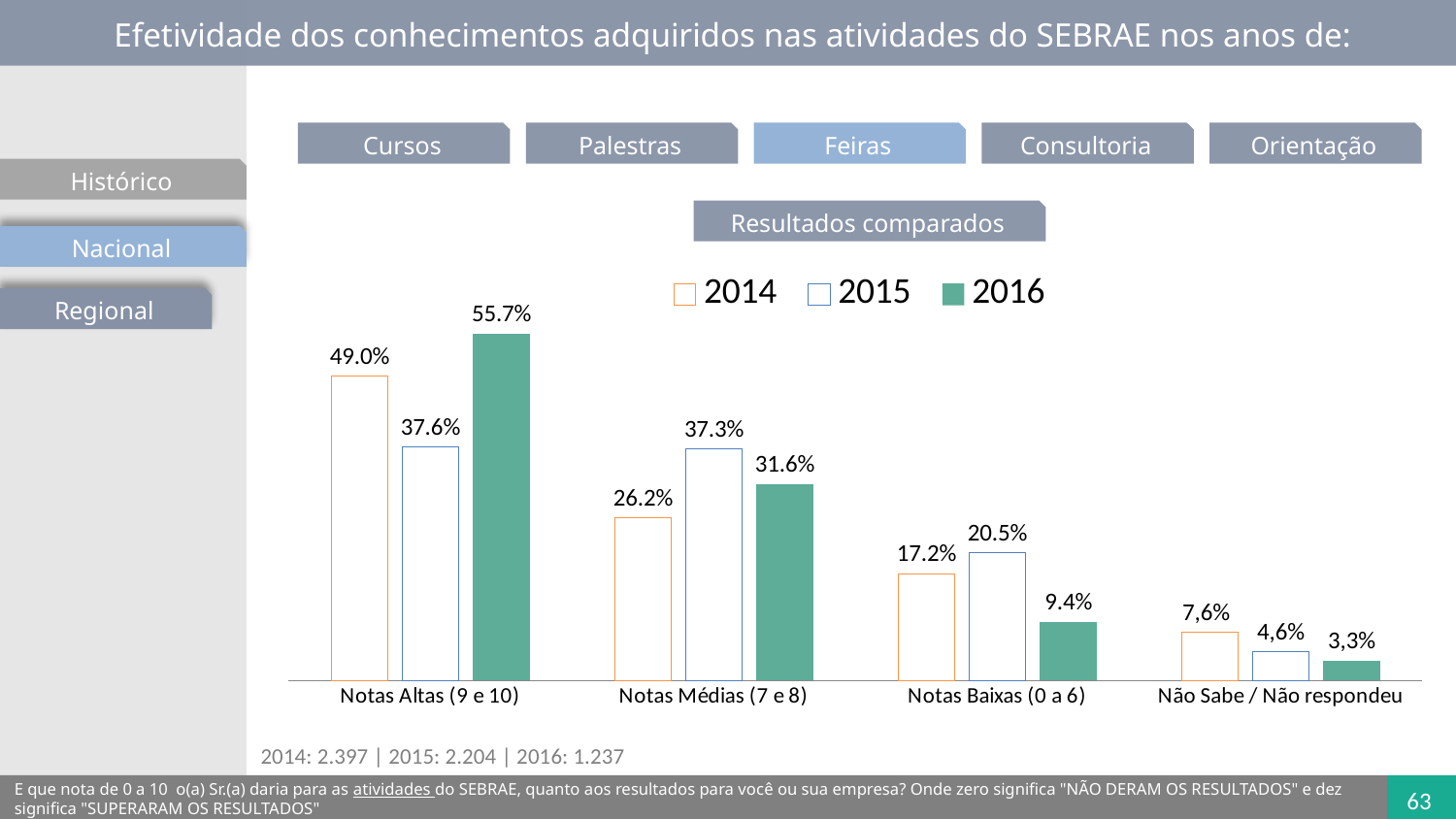
What is the value for 2014 in the Notas Médias (7 e 8) category? 26.2% What is the value for 2016 in the Não Sabe / Não respondeu category? 3,3% By how many percentage points does the 2016 value exceed the 2014 value in the Notas Altas (9 e 10) category? 6.7 percentage points What is the value for 2015 in the Notas Baixas (0 a 6) category? 20.5% How many categories are shown on the x axis of the chart? 4 In which category does the 2016 series reach its highest value? Notas Altas (9 e 10) In which category does the 2014 series have its lowest value? Não Sabe / Não respondeu What kind of chart is shown on the slide? Bar chart How many series does the chart legend list? 3 Do the 2016 values rise or fall moving from Notas Altas (9 e 10) to Não Sabe / Não respondeu? Fall Which is larger in the Notas Altas (9 e 10) category: the 2014 value or the 2015 value? 2014 What is the value for 2016 in the Notas Altas (9 e 10) category? 55.7%